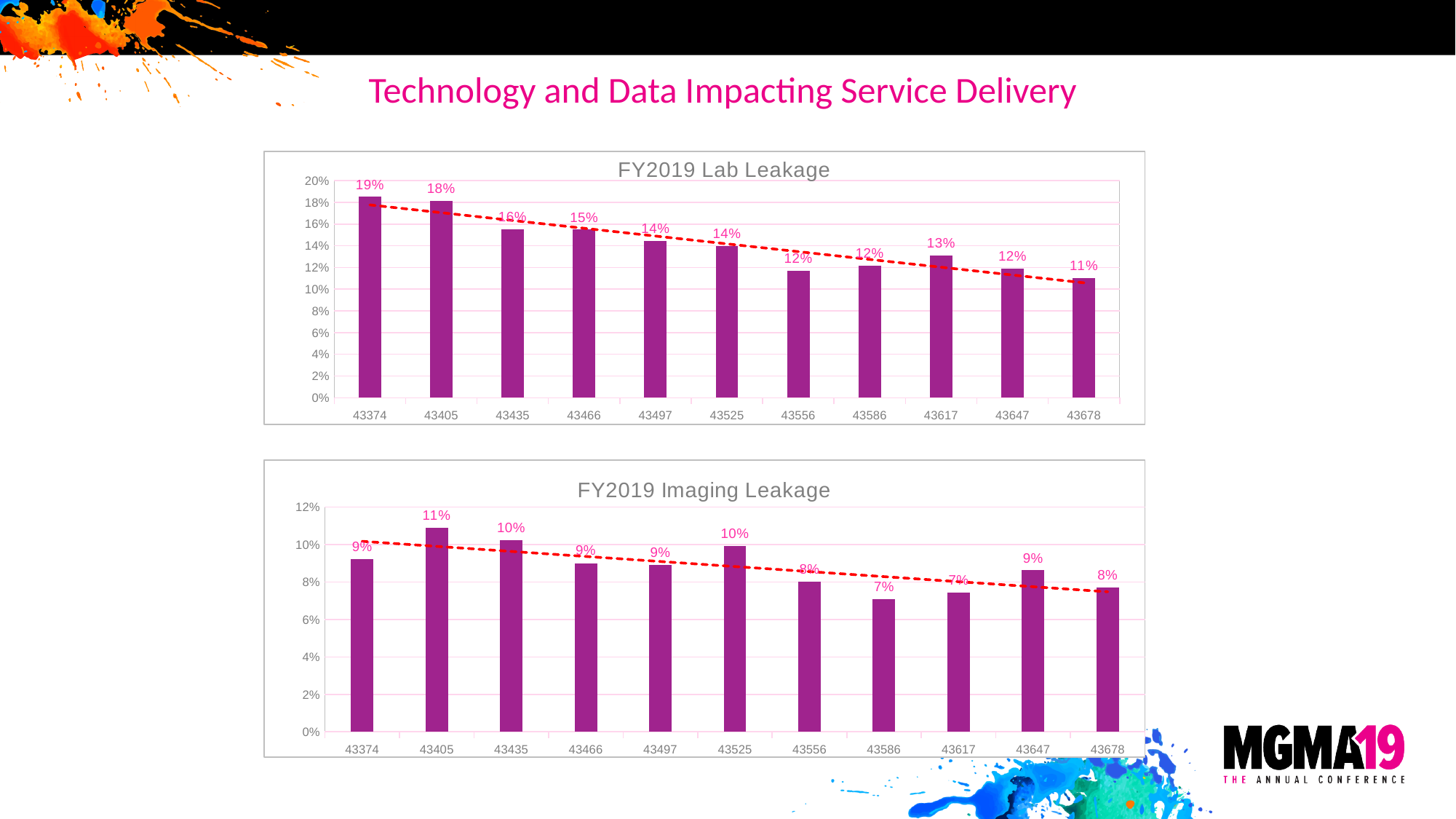
In the FY2019 Imaging Leakage chart, which is larger, the value for 43435 or the value for 43586? 43435 In the FY2019 Imaging Leakage chart, which category has the highest value? 43405 In the FY2019 Lab Leakage chart, what is the value for 43374? 19% In the FY2019 Lab Leakage chart, which category has the lowest value? 43678 In the FY2019 Imaging Leakage chart, what is the value for 43586? 7% In the FY2019 Lab Leakage chart, which category has the highest value? 43374 In the FY2019 Lab Leakage chart, do the values generally rise or fall from left to right? Fall How many categories are shown in the FY2019 Imaging Leakage chart? 11 In the FY2019 Imaging Leakage chart, what is the value for 43405? 11% What kind of chart is the FY2019 Lab Leakage chart? Bar chart In the FY2019 Lab Leakage chart, what is the value for 43678? 11% In the FY2019 Lab Leakage chart, what is the difference between the values for 43374 and 43678? 8%